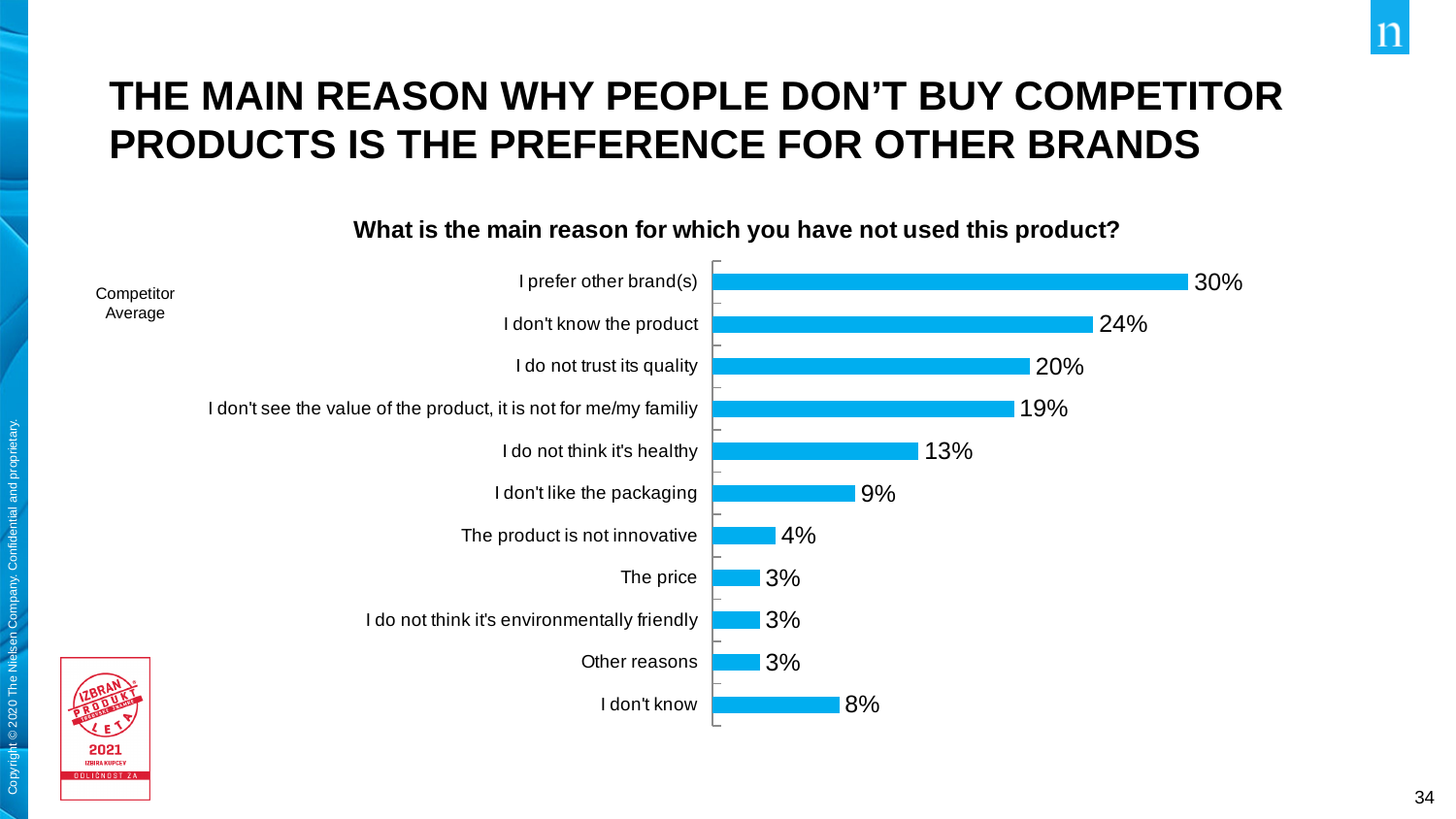
What is the value for "I don't know the product"? 24% Which is larger, the value for "I don't like the packaging" or the value for "I don't know"? I don't like the packaging How many reasons (categories) are shown in the chart? 11 What is the difference between "I do not trust its quality" and "I don't like the packaging"? 11% What is the difference between "I prefer other brand(s)" and "I don't know the product"? 6% What kind of chart is shown on the slide? Bar chart What question is the chart based on, as shown in the chart title? What is the main reason for which you have not used this product? What percentage of respondents said "I prefer other brand(s)" as the main reason for not using the product? 30% Which is larger, the value for "The product is not innovative" or the value for "I do not think it's healthy"? I do not think it's healthy What is the value for "I don't know"? 8% What is the value for "I do not think it's healthy"? 13% Which reason has the highest percentage? I prefer other brand(s)